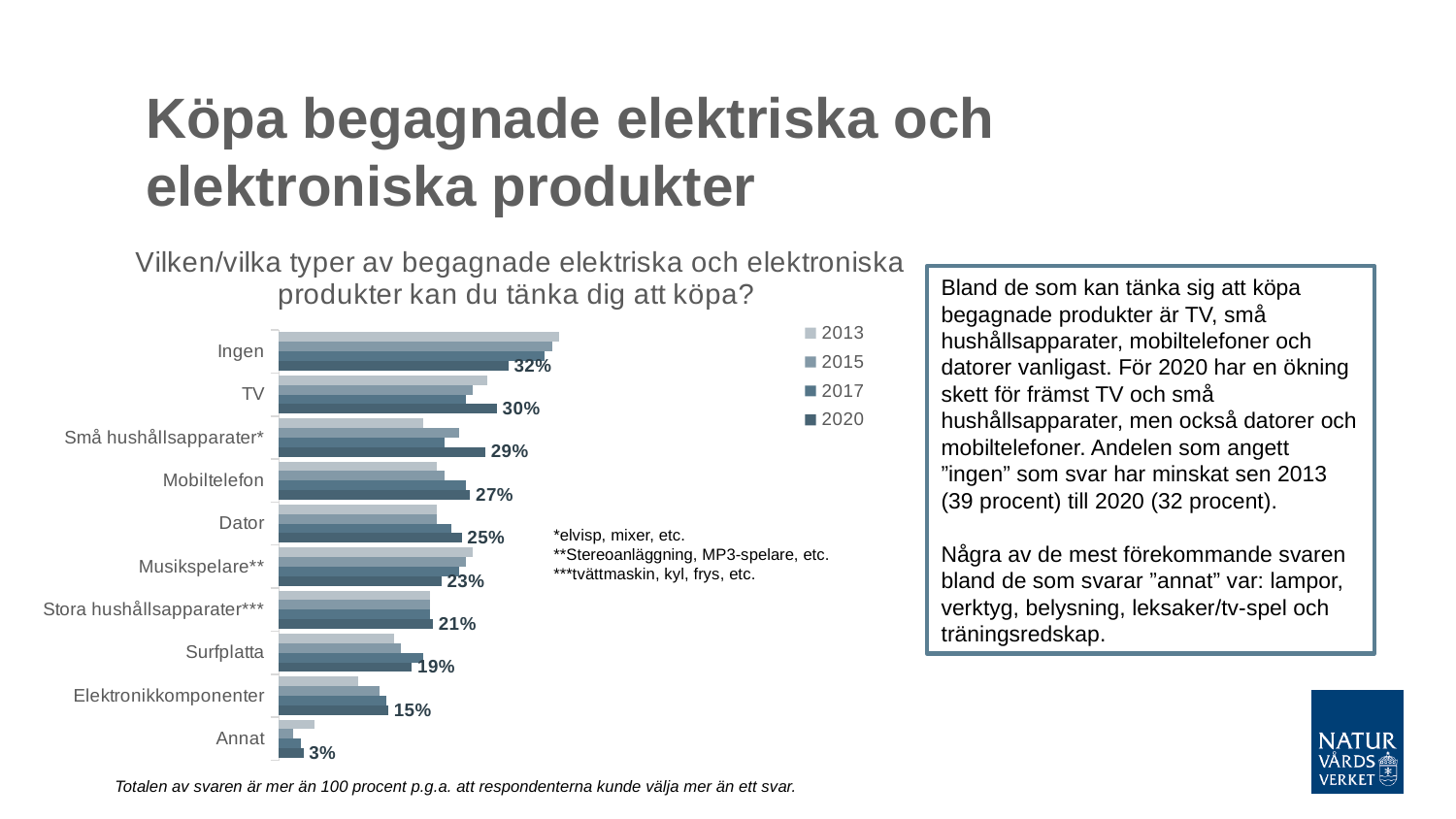
How many categories are shown on the chart? 10 What is the 2020 value for TV? 30% Which category has the lowest 2020 value? Annat What is the 2020 value for Surfplatta? 19% What is the 2020 value for Mobiltelefon? 27% What kind of chart is shown on the slide? Bar chart Which has a larger 2020 value, Dator or Musikspelare**? Dator Which years are listed in the chart legend? 2013, 2015, 2017, 2020 How many series does the legend list? 4 What is the difference between the 2020 values for Ingen and Elektronikkomponenter? 17% What is the 2020 value for Annat? 3% Which category has the highest 2020 value? Ingen